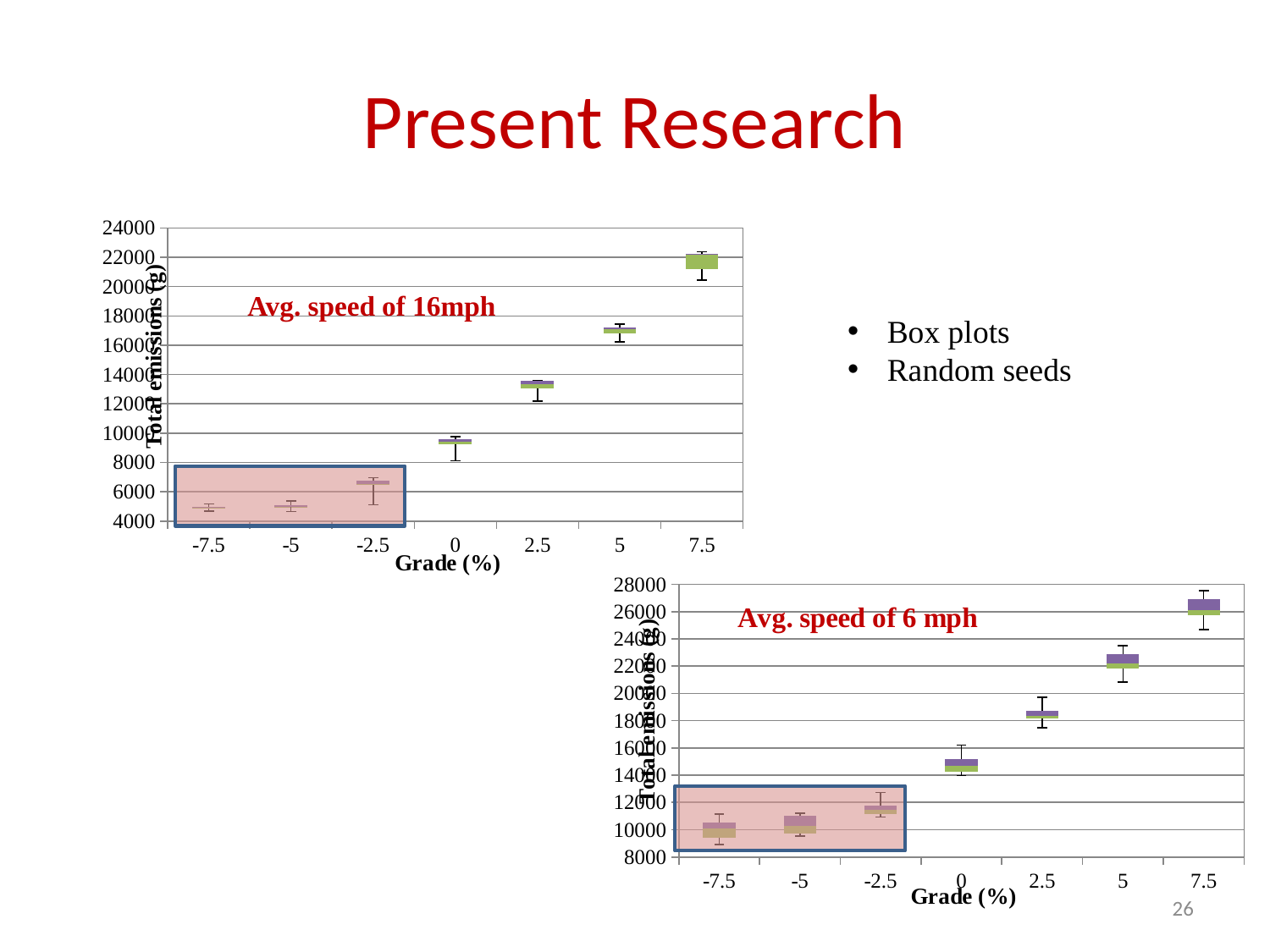
What is the x-axis title of the 'Avg. speed of 6 mph' chart? Grade (%) In the 'Avg. speed of 6 mph' chart, which grade has the highest total emissions? 7.5 In the 'Avg. speed of 16mph' chart, which grade has the highest total emissions? 7.5 In the 'Avg. speed of 6 mph' chart, which has higher total emissions, grade 2.5 or grade 0? Grade 2.5 In the 'Avg. speed of 6 mph' chart, is the value for grade 7.5 greater or less than 24000? greater In the 'Avg. speed of 16mph' chart, do total emissions rise or fall as grade increases along the x axis? Rise In the 'Avg. speed of 16mph' chart, is the value for grade 7.5 greater or less than 20000? greater In the 'Avg. speed of 6 mph' chart, is the value for grade 0 greater or less than 16000? less In the 'Avg. speed of 16mph' chart, how many grade categories are plotted on the x axis? 7 In the 'Avg. speed of 16mph' chart, which has higher total emissions, grade 5 or grade 2.5? Grade 5 What kind of chart is the 'Avg. speed of 16mph' chart? Box plot